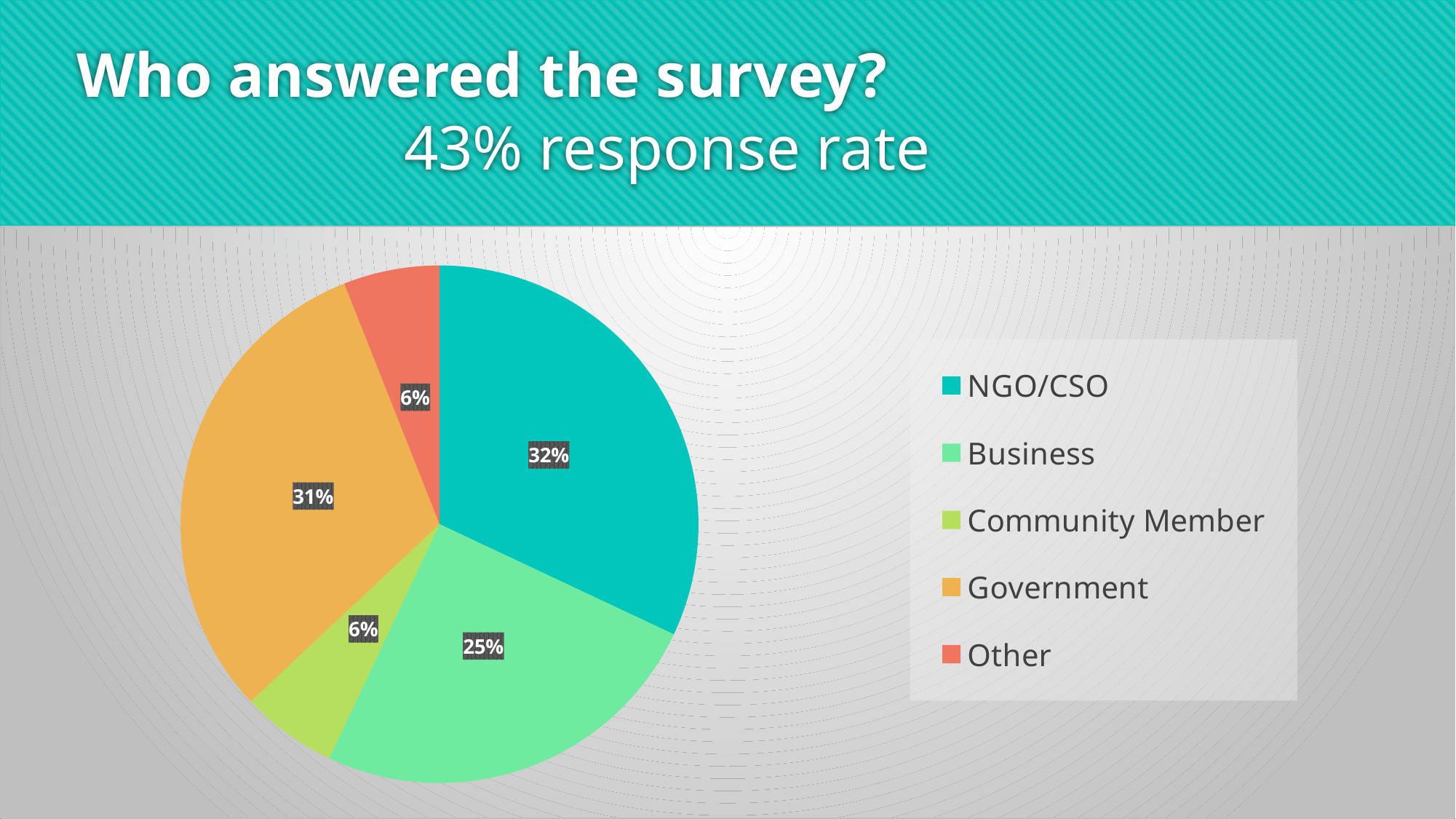
What type of chart is shown on the slide? Pie chart What is the title of the slide containing the pie chart? Who answered the survey? What percentage of survey respondents were Community Member? 6% What percentage of survey respondents were NGO/CSO? 32% Which is larger, the share for NGO/CSO or the share for Business? NGO/CSO What is the difference in percentage points between the Government share and the Other share? 25 percentage points What percentage of survey respondents were Business? 25% What percentage of survey respondents were Government? 31% What is the difference in percentage points between the NGO/CSO share and the Business share? 7 percentage points Which category has the largest share of the pie? NGO/CSO How many slices does the pie chart have? 5 How many entries does the legend list? 5